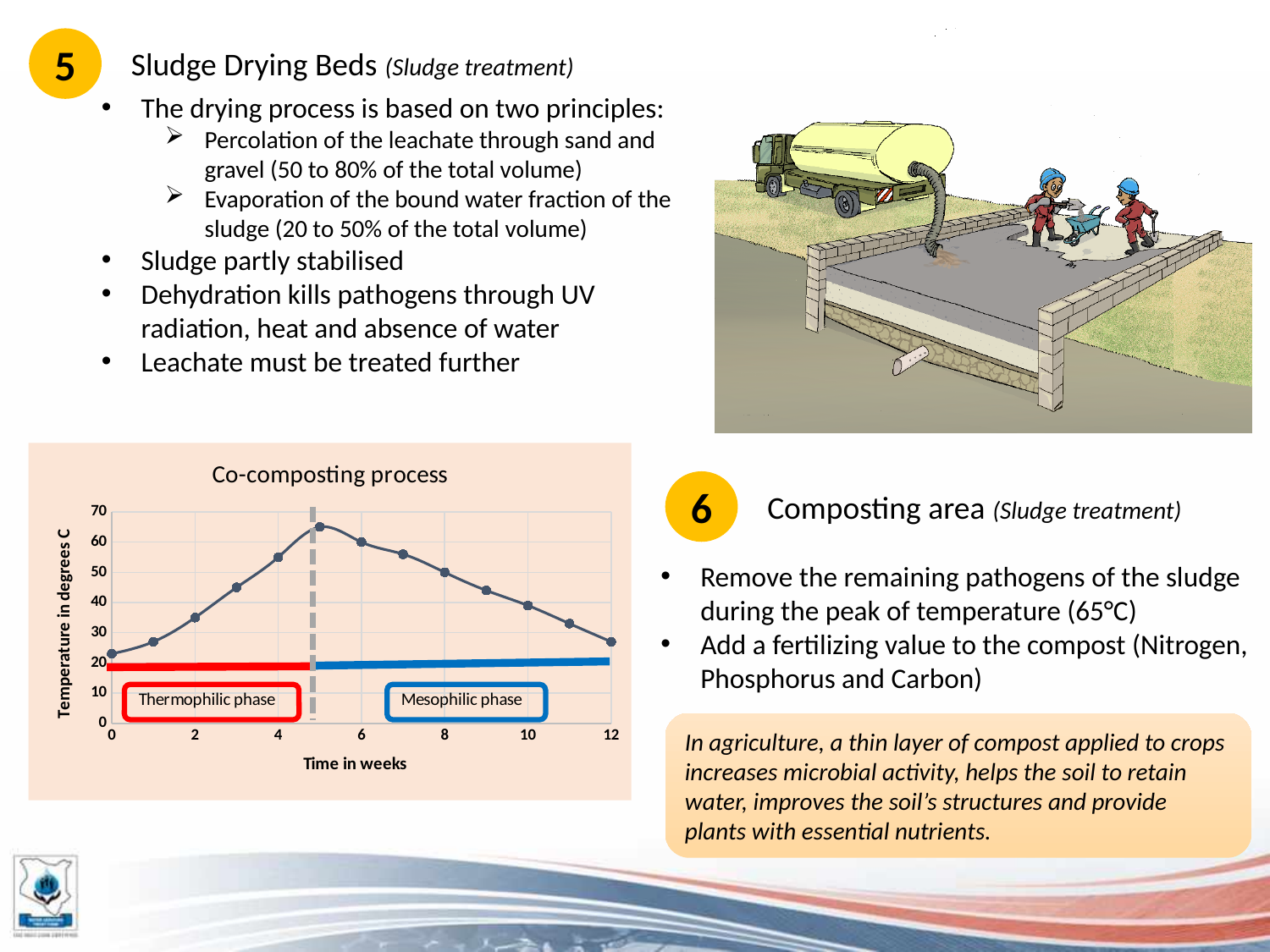
Does the temperature rise or fall between week 0 and week 5 on the 'Co-composting process' chart? rise Is the temperature at week 0 greater or less than 30 on the 'Co-composting process' chart? less Is the temperature at week 12 greater or less than 30 on the 'Co-composting process' chart? less How many data points are plotted on the 'Co-composting process' chart? 13 Does the temperature rise or fall between week 5 and week 12 on the 'Co-composting process' chart? fall What kind of chart is the 'Co-composting process' chart? line chart Is the temperature at week 4 greater or less than 50 on the 'Co-composting process' chart? greater Which has the higher temperature on the 'Co-composting process' chart, week 1 or week 7? week 7 What is the title of the chart on the slide? Co-composting process What is the label of the x axis of the 'Co-composting process' chart? Time in weeks At which week does the temperature reach its highest value on the 'Co-composting process' chart? 5